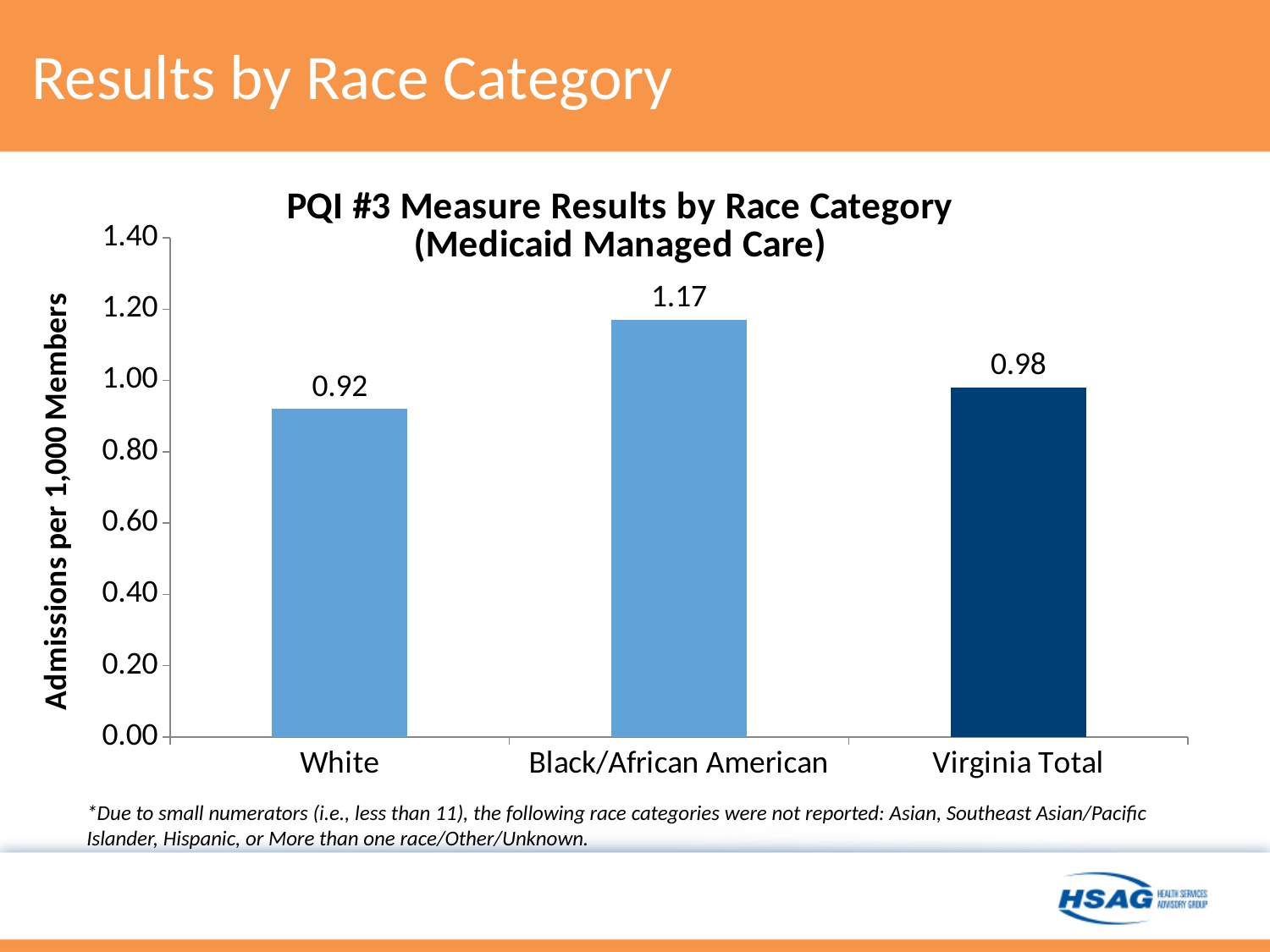
What is the label of the y axis? Admissions per 1,000 Members Is the value for Black/African American greater or less than 1.00? greater What kind of chart is shown on the slide? bar chart Which category has the highest value? Black/African American What is the value for Virginia Total? 0.98 What is the value for White? 0.92 What is the difference between the values for Black/African American and White? 0.25 Which category has the lowest value? White Which is larger, the value for White or the value for Virginia Total? Virginia Total What is the difference between the values for Virginia Total and White? 0.06 How many categories are shown on the x axis? 3 What is the value for Black/African American? 1.17